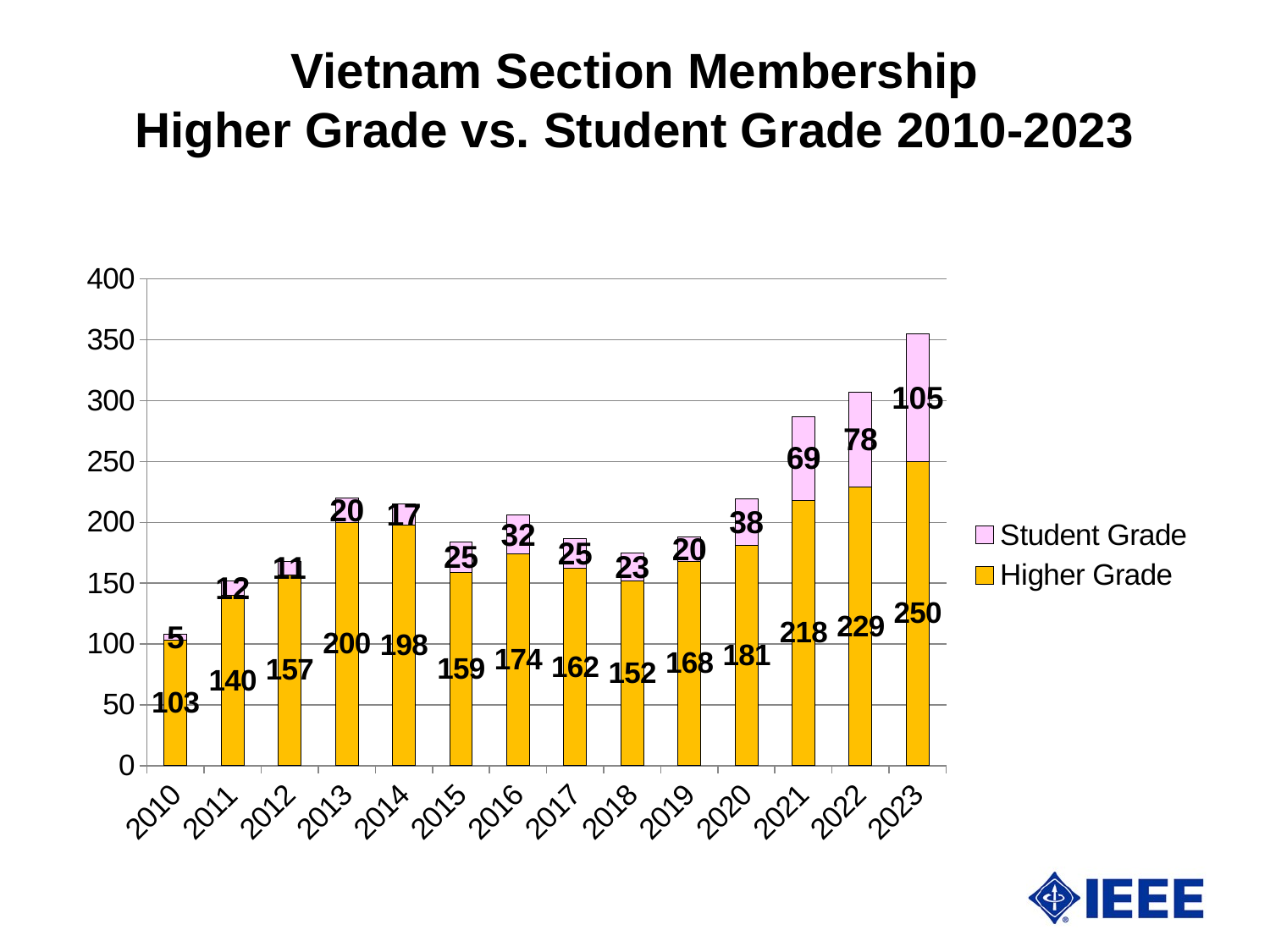
Is the total height of the 2023 bar greater or less than 300? greater What kind of chart is shown on the slide? Stacked bar chart What is the Student Grade membership value for 2021? 69 How many series does the legend list? 2 What is the Higher Grade membership value for 2013? 200 What is the difference between the Higher Grade membership in 2023 and in 2022? 21 Which is larger, the Student Grade value for 2016 or for 2020? 2020 Which year has the highest Student Grade membership? 2023 Which year has the lowest Higher Grade membership? 2010 Which series is shown in pink in the legend? Student Grade How many years are shown on the x axis? 14 What is the total membership (Higher Grade plus Student Grade) for 2023? 355